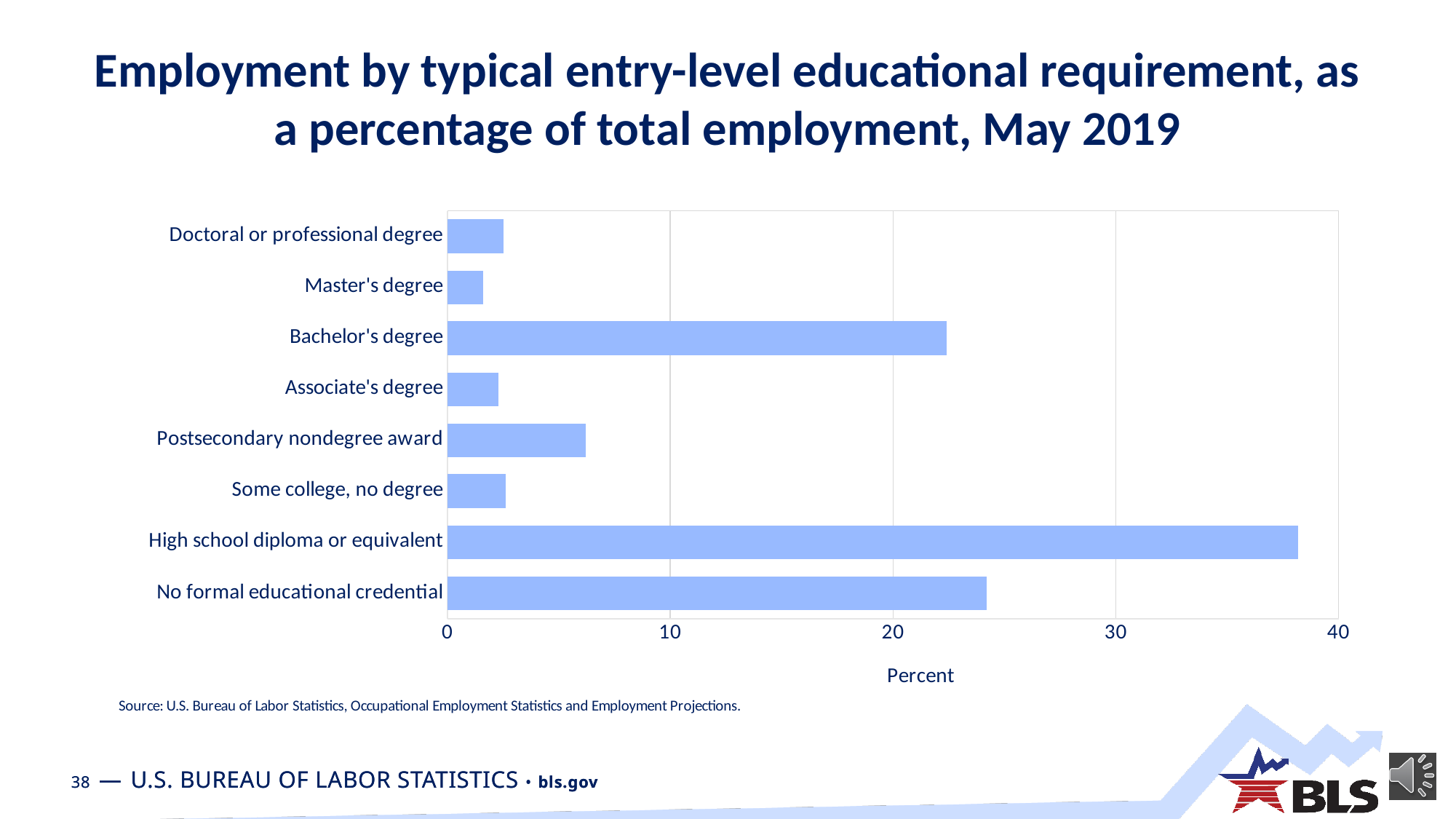
Is the value for Postsecondary nondegree award greater or less than 10? less Which educational requirement category has the lowest percentage of total employment? Master's degree What is the title of the chart? Employment by typical entry-level educational requirement, as a percentage of total employment, May 2019 What kind of chart is shown on the slide? bar chart Which has a larger share of total employment: Postsecondary nondegree award or Associate's degree? Postsecondary nondegree award What is the label on the horizontal axis of the chart? Percent Which has a larger share of total employment: Bachelor's degree or No formal educational credential? No formal educational credential Which educational requirement category has the highest percentage of total employment? High school diploma or equivalent How many educational requirement categories are plotted in the chart? 8 Is the value for No formal educational credential greater or less than 20? greater Is the value for Bachelor's degree greater or less than 30? less